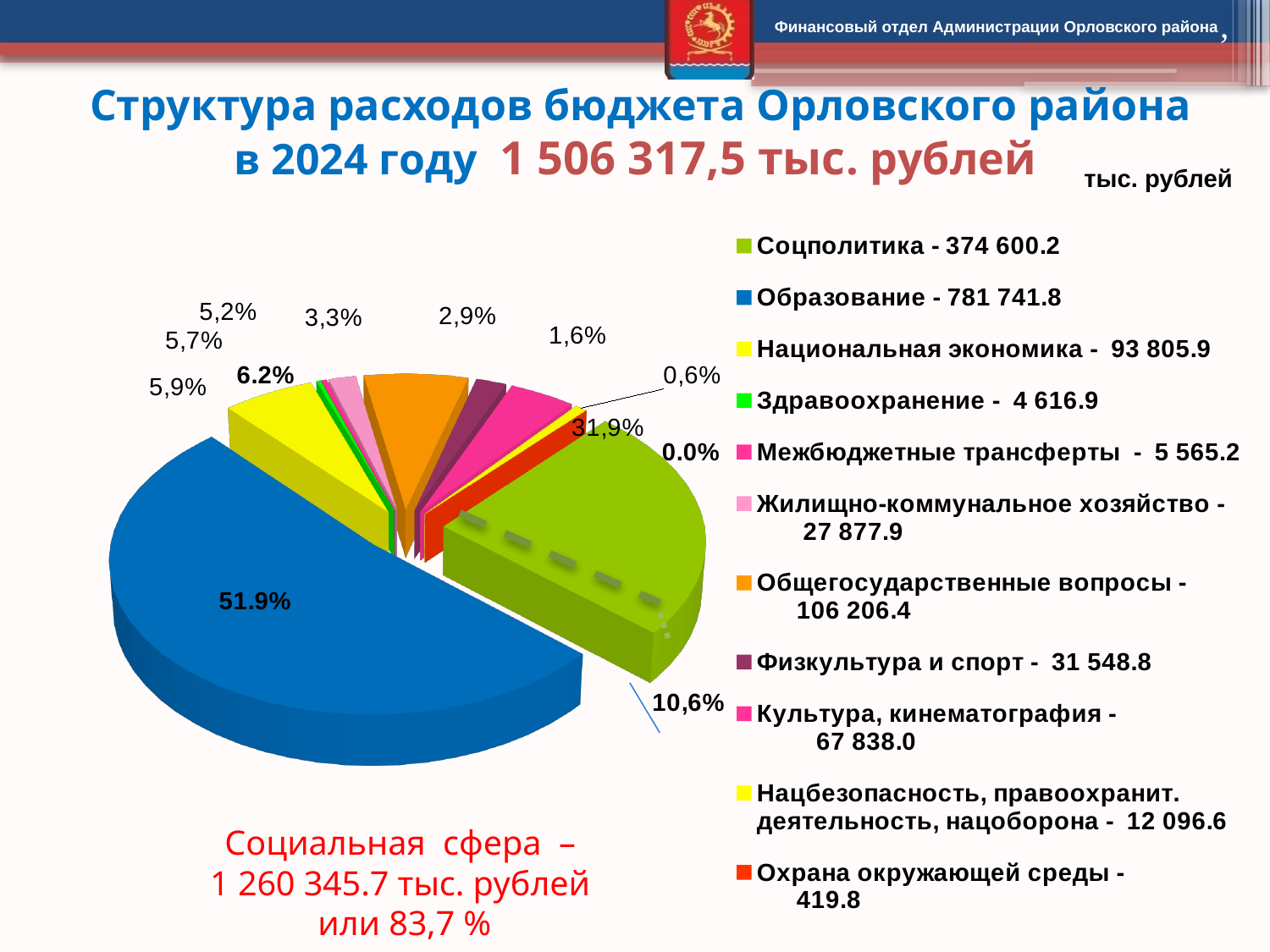
What type of chart is shown on the slide? pie chart What is the value for Здравоохранение? 4 616.9 What is the value for Соцполитика in the legend? 374 600.2 Which category has the smallest value in the pie chart? Охрана окружающей среды What percentage share is labelled on the blue slice (Образование)? 51.9% What total budget expenditure amount is stated in the slide title? 1 506 317,5 тыс. рублей What is the difference between the values for Образование and Соцполитика? 407 141.6 What is the value for Культура, кинематография? 67 838.0 What is the value for Образование in the legend? 781 741.8 Which category has the largest value in the pie chart? Образование How many categories does the legend of the pie chart list? 11 Which is larger: Национальная экономика or Общегосударственные вопросы? Общегосударственные вопросы